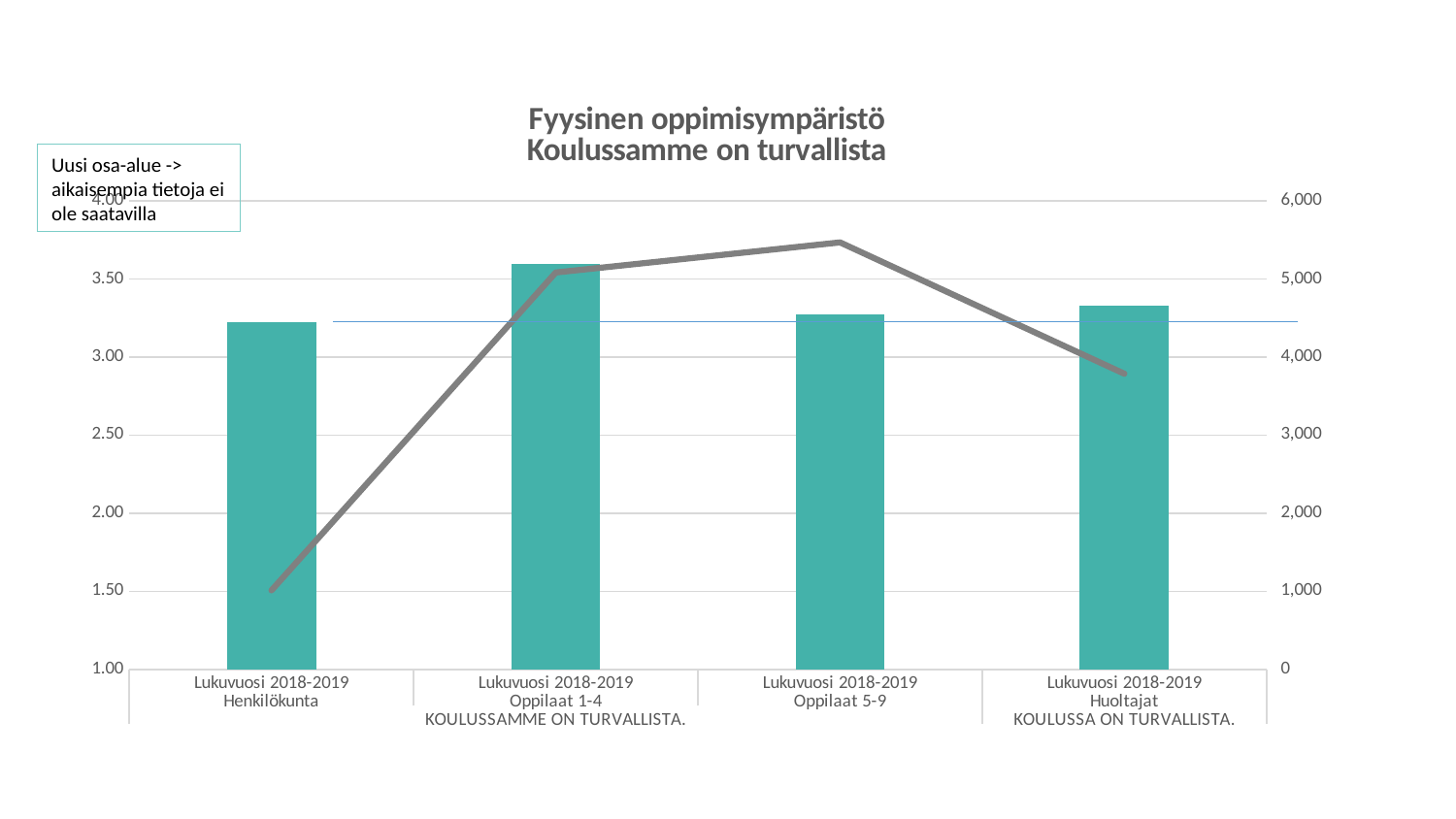
Is the bar value for Lukuvuosi 2018-2019 Henkilökunta greater or less than 3.00? greater Is the line value for Lukuvuosi 2018-2019 Henkilökunta greater or less than 2,000 on the right axis? less Does the line rise or fall from Lukuvuosi 2018-2019 Henkilökunta to Lukuvuosi 2018-2019 Oppilaat 5-9? rise Is the line value for Lukuvuosi 2018-2019 Oppilaat 5-9 greater or less than 5,000 on the right axis? greater How many categories are shown along the x axis? 4 What is the title of the chart? Fyysinen oppimisympäristö Koulussamme on turvallista Which category has the highest point on the line? Lukuvuosi 2018-2019 Oppilaat 5-9 Which category has the lowest point on the line? Lukuvuosi 2018-2019 Henkilökunta What kind of chart is shown on the slide? A bar chart combined with a line Which category has the tallest bar? Lukuvuosi 2018-2019 Oppilaat 1-4 Which bar is taller, Lukuvuosi 2018-2019 Oppilaat 1-4 or Lukuvuosi 2018-2019 Huoltajat? Lukuvuosi 2018-2019 Oppilaat 1-4